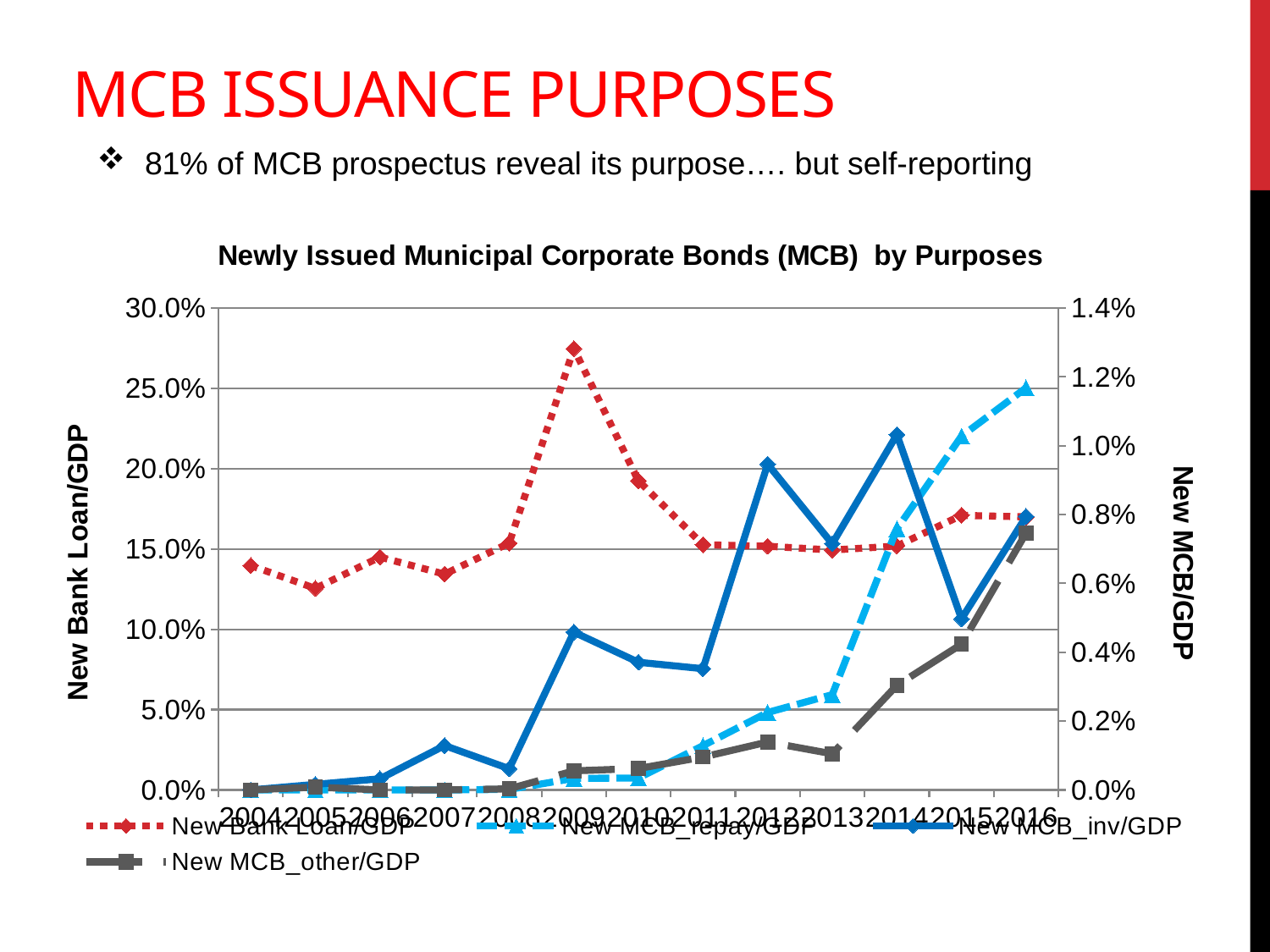
Which is larger, New MCB_inv/GDP in 2012 or in 2013? 2012 What kind of chart is shown on the slide? line chart How many years are plotted along the x axis? 13 In which year does New Bank Loan/GDP reach its highest value? 2009 Does New MCB_repay/GDP generally rise or fall from 2004 to 2016? rise Is the value of New MCB_other/GDP in 2014 greater or less than 0.4%? less How many series does the legend list? 4 What is the label of the right-hand vertical axis? New MCB/GDP Is the value of New Bank Loan/GDP in 2009 greater or less than 25.0%? greater Is the value of New Bank Loan/GDP in 2005 greater or less than 15.0%? less In which year is New MCB_repay/GDP at its highest? 2016